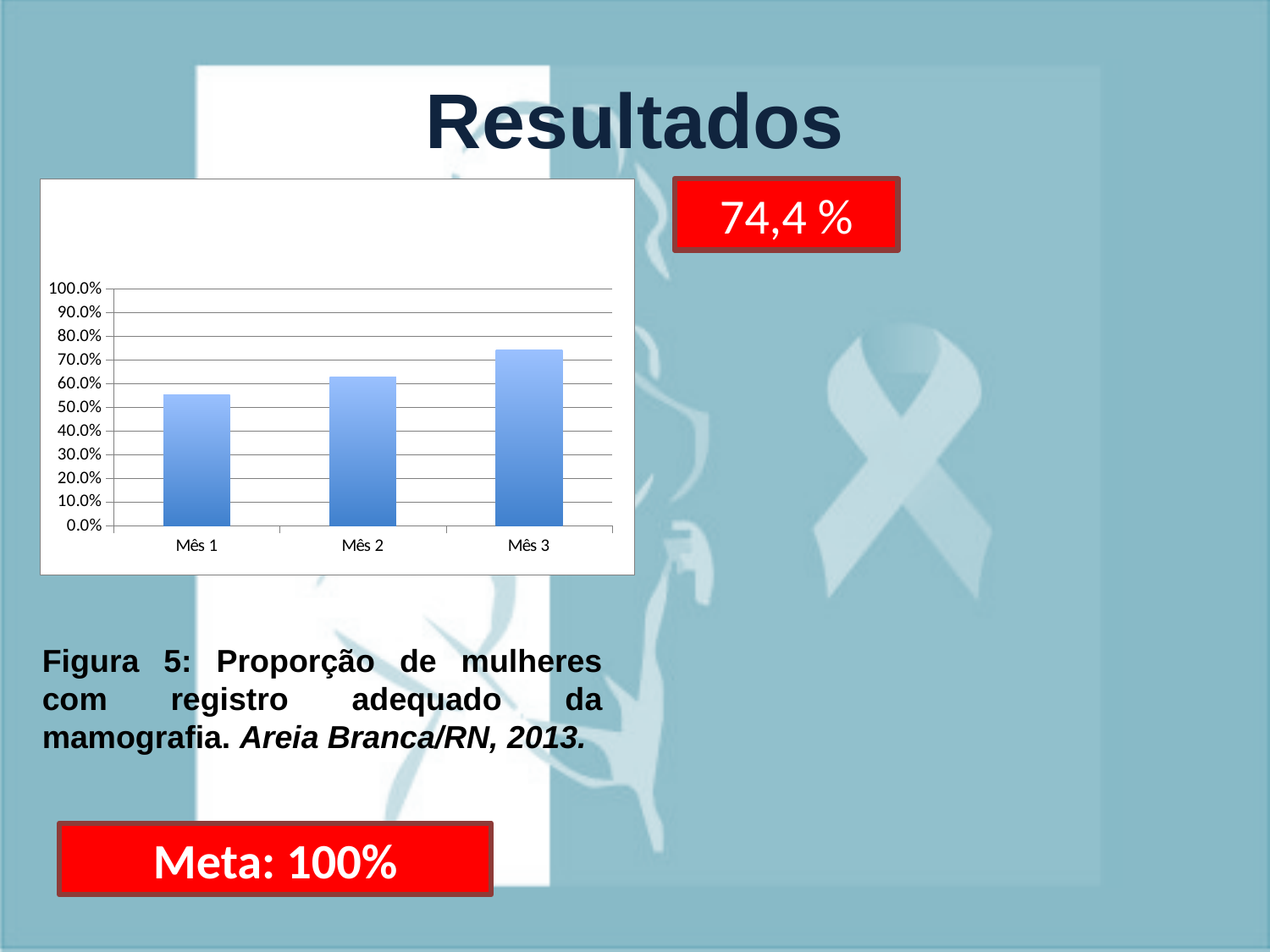
What kind of chart is shown on the slide? bar chart How many categories (months) are plotted on the chart? 3 Which month has the lowest bar on the chart? Mês 1 What is the figure number given in the caption below the chart? Figura 5 Is the value for Mês 2 greater or less than 70.0%? less Is the value for Mês 1 greater or less than 50.0%? greater Which is larger, the value for Mês 2 or the value for Mês 1? Mês 2 Do the values rise or fall from Mês 1 to Mês 3? rise Which month has the highest bar on the chart? Mês 3 Is the value for Mês 3 greater or less than 70.0%? greater